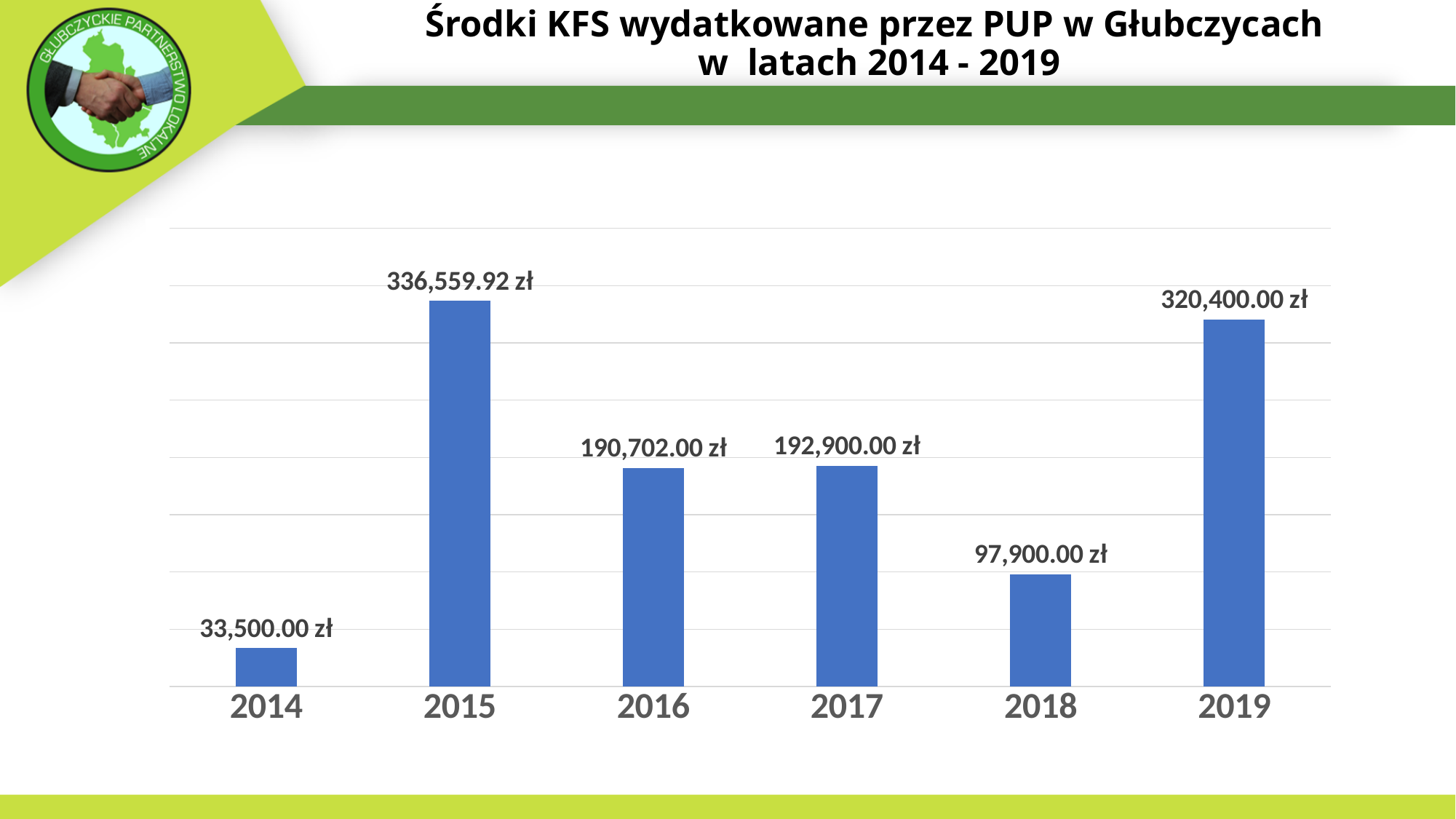
Did the value rise or fall from 2017 to 2018? fall Which is larger, the value for 2015 or the value for 2019? 2015 What is the difference between the values for 2017 and 2016? 2,198.00 zł What value is shown for 2014? 33,500.00 zł What value is shown for 2015? 336,559.92 zł Which year has the highest value? 2015 What value is shown for 2018? 97,900.00 zł What is the difference between the values for 2019 and 2018? 222,500.00 zł How many years are shown on the x axis? 6 What kind of chart is shown on the slide? bar chart Which is larger, the value for 2016 or the value for 2017? 2017 Which year has the lowest value? 2014